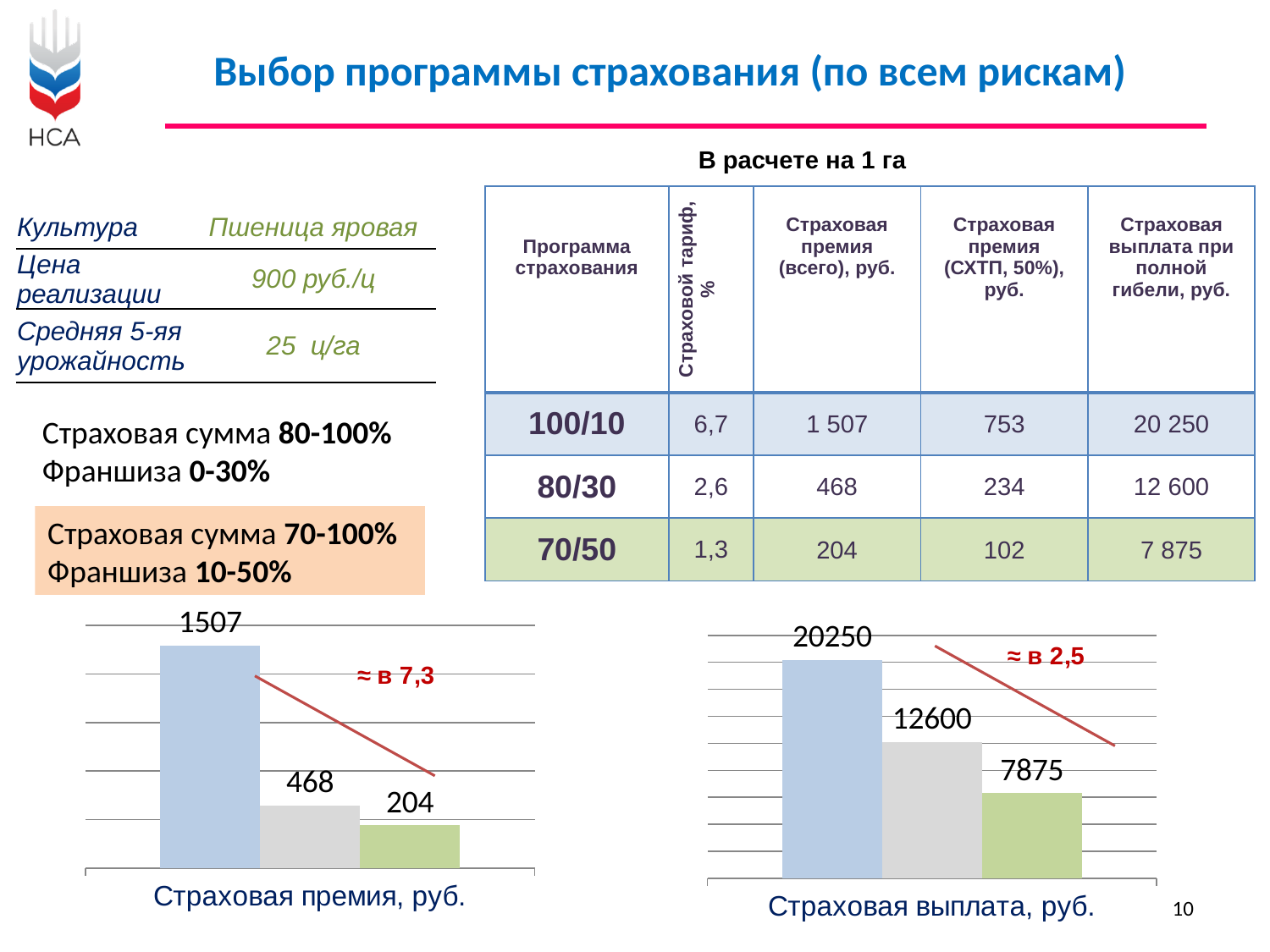
In the chart titled "Страховая премия, руб.", do the values rise or fall from left to right? fall In the chart titled "Страховая выплата, руб.", what is the difference between the middle (grey) bar and the rightmost (green) bar? 4725 What kind of chart is the chart titled "Страховая премия, руб."? bar chart In the chart titled "Страховая премия, руб.", what is the value of the middle (grey) bar? 468 In the chart titled "Страховая премия, руб.", what is the value of the tallest (leftmost, blue) bar? 1507 In the chart titled "Страховая премия, руб.", what is the value of the rightmost (green) bar? 204 How many bars are plotted in the chart titled "Страховая премия, руб."? 3 In the chart titled "Страховая выплата, руб.", which bar is the lowest? the rightmost (green) bar, 7875 In the chart titled "Страховая выплата, руб.", what ratio is annotated in red next to the trend line? ≈ в 2,5 In the chart titled "Страховая выплата, руб.", what is the value of the rightmost (green) bar? 7875 In the chart titled "Страховая премия, руб.", what is the difference between the highest and lowest bar values? 1303 In the chart titled "Страховая выплата, руб.", what is the value of the leftmost (blue) bar? 20250